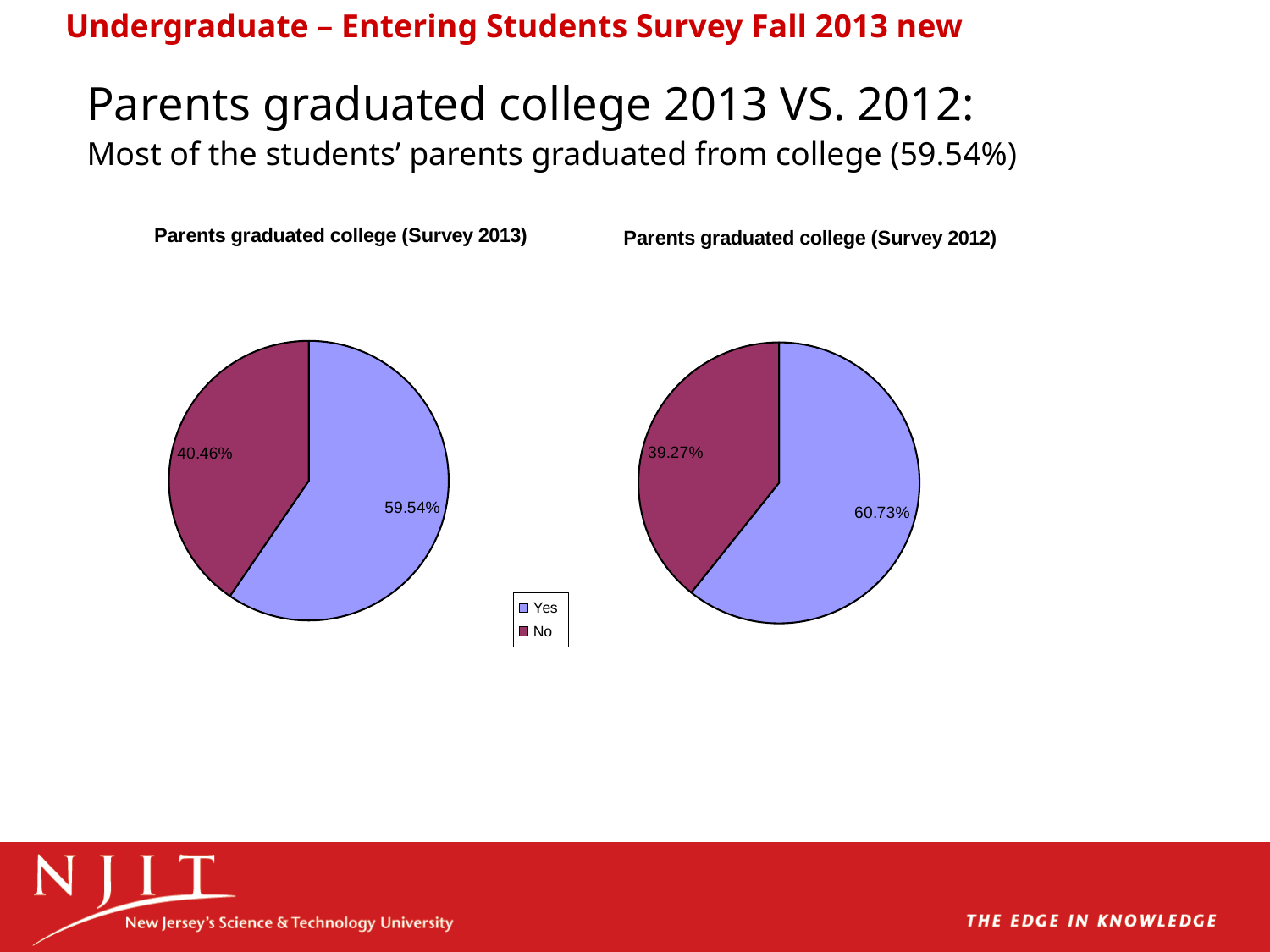
Which chart shows a larger Yes share, the Survey 2013 chart or the Survey 2012 chart? Survey 2012 In the 'Parents graduated college (Survey 2012)' chart, what percentage of students answered No? 39.27% In the 'Parents graduated college (Survey 2012)' chart, which response has the smallest slice? No In the 'Parents graduated college (Survey 2012)' chart, what percentage of students answered Yes? 60.73% In the 'Parents graduated college (Survey 2013)' chart, what percentage of students answered Yes? 59.54% In the 'Parents graduated college (Survey 2013)' chart, what percentage of students answered No? 40.46% How many slices does the 'Parents graduated college (Survey 2012)' pie chart have? 2 In the 'Parents graduated college (Survey 2013)' chart, which response has the largest slice? Yes What type of chart is the 'Parents graduated college (Survey 2013)' chart? Pie chart What colour represents the No response in the pie charts? Dark red (maroon) In the 'Parents graduated college (Survey 2012)' chart, what is the difference between the Yes and No percentages? 21.46% In the 'Parents graduated college (Survey 2013)' chart, what is the difference between the Yes and No percentages? 19.08%